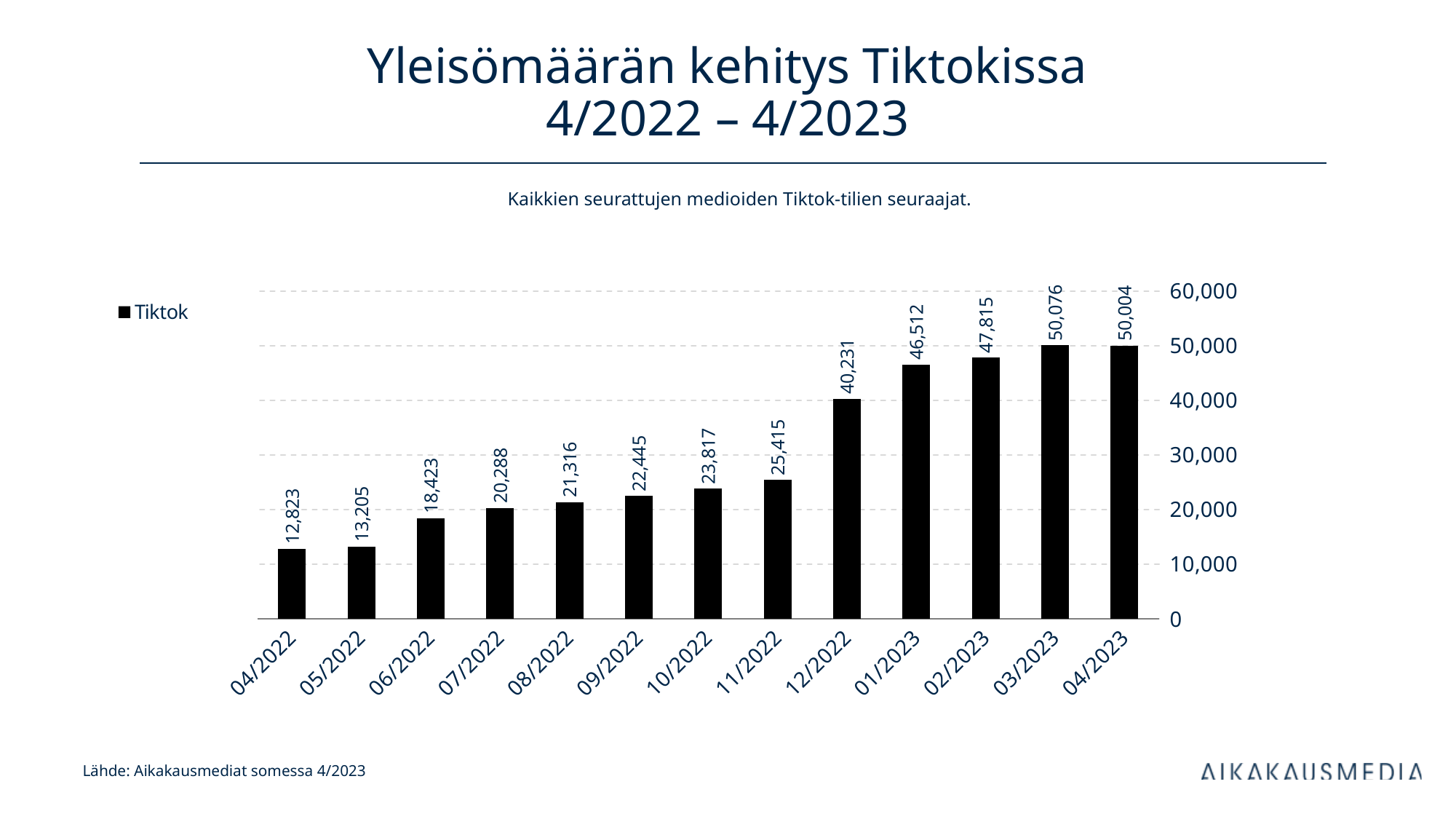
Which month has the highest value? 03/2023 How many months are shown on the x axis? 13 Which month has the lowest value? 04/2022 Which is larger, the value for 01/2023 or the value for 02/2023? 02/2023 What is the value for 09/2022? 22,445 Is the value for 10/2022 greater or less than 20,000? greater Do the values generally rise or fall from 04/2022 to 03/2023? rise What is the value for 12/2022? 40,231 What is the value for 04/2022? 12,823 What is the difference between the values for 04/2023 and 04/2022? 37,181 What kind of chart is shown on the slide? bar chart What is the difference between the values for 12/2022 and 11/2022? 14,816